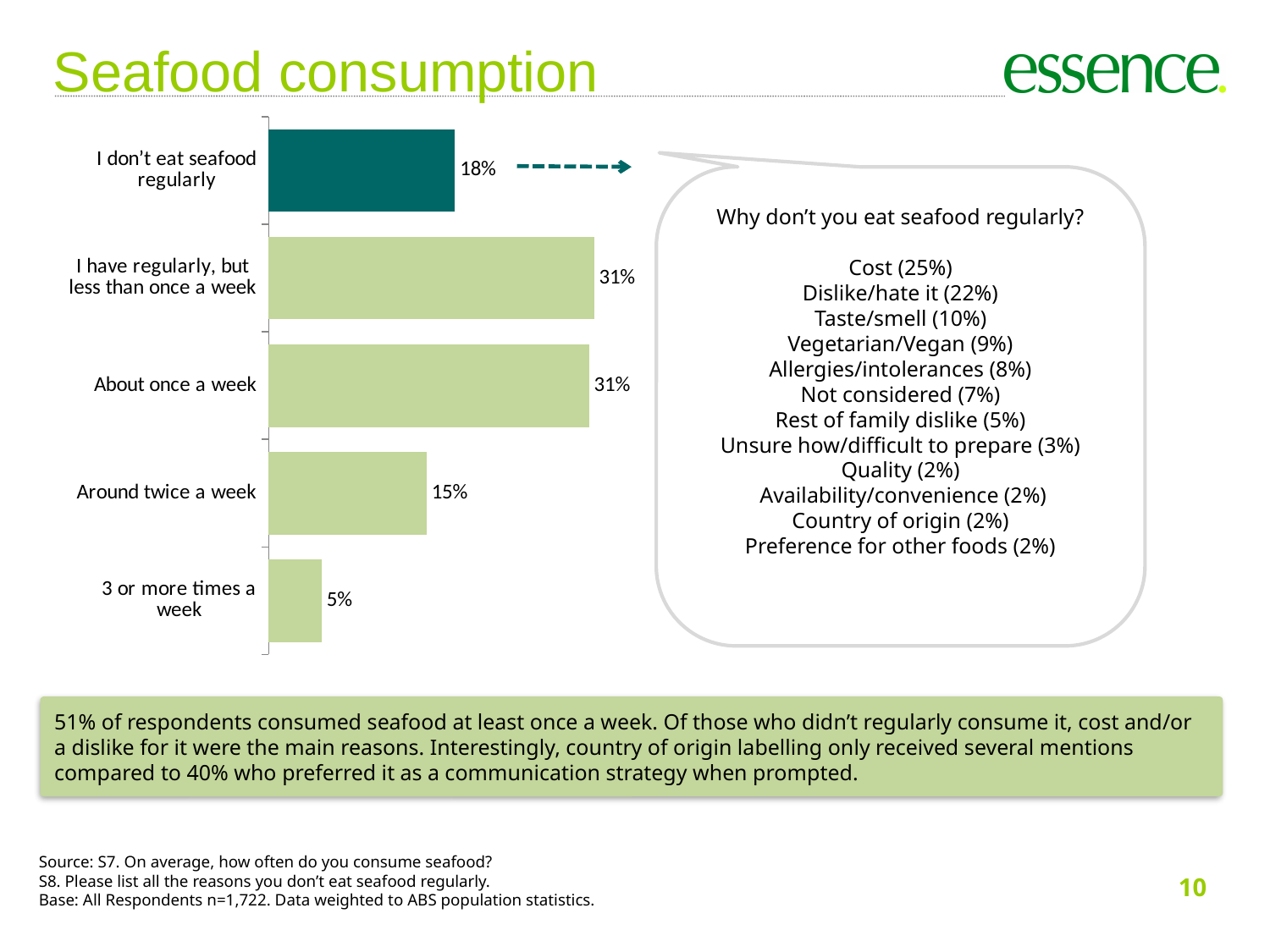
What percentage of respondents said they don't eat seafood regularly? 18% What type of chart is shown on the slide? Bar chart What is the difference between 'About once a week' and '3 or more times a week'? 26% What is the combined value of 'I have regularly, but less than once a week' and 'About once a week'? 62% What is the value for 'Around twice a week'? 15% Which is larger: the value for 'I don't eat seafood regularly' or the value for 'Around twice a week'? I don't eat seafood regularly What is the difference between the values for 'I don't eat seafood regularly' and 'Around twice a week'? 3% What is the value for '3 or more times a week'? 5% Which category has the lowest value in the chart? 3 or more times a week How many categories are shown in the bar chart? 5 What is the value for 'About once a week'? 31% Which bar in the chart is coloured dark teal rather than light green? I don't eat seafood regularly